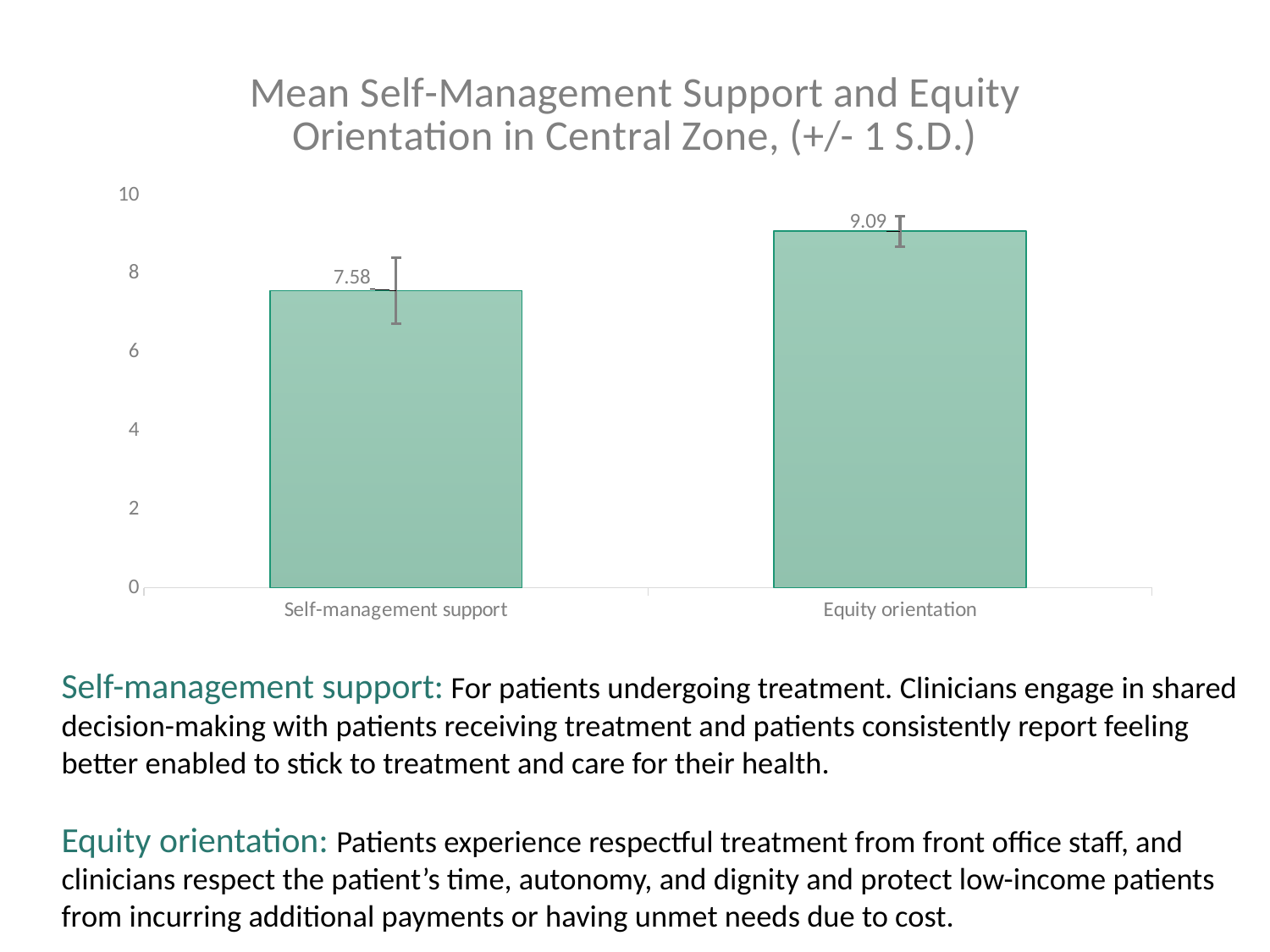
What is the mean value for Equity orientation? 9.09 Which category has the lower mean value? Self-management support What is the difference between the Equity orientation and Self-management support means? 1.51 Which category has the higher mean value? Equity orientation How many categories are shown on the chart? 2 Is the value for Equity orientation greater or less than 8? greater What is the maximum value shown on the vertical axis? 10 What is the title of the chart? Mean Self-Management Support and Equity Orientation in Central Zone, (+/- 1 S.D.) What is the mean value for Self-management support? 7.58 Is the value for Self-management support greater or less than 8? less What kind of chart is shown on the slide? Bar chart